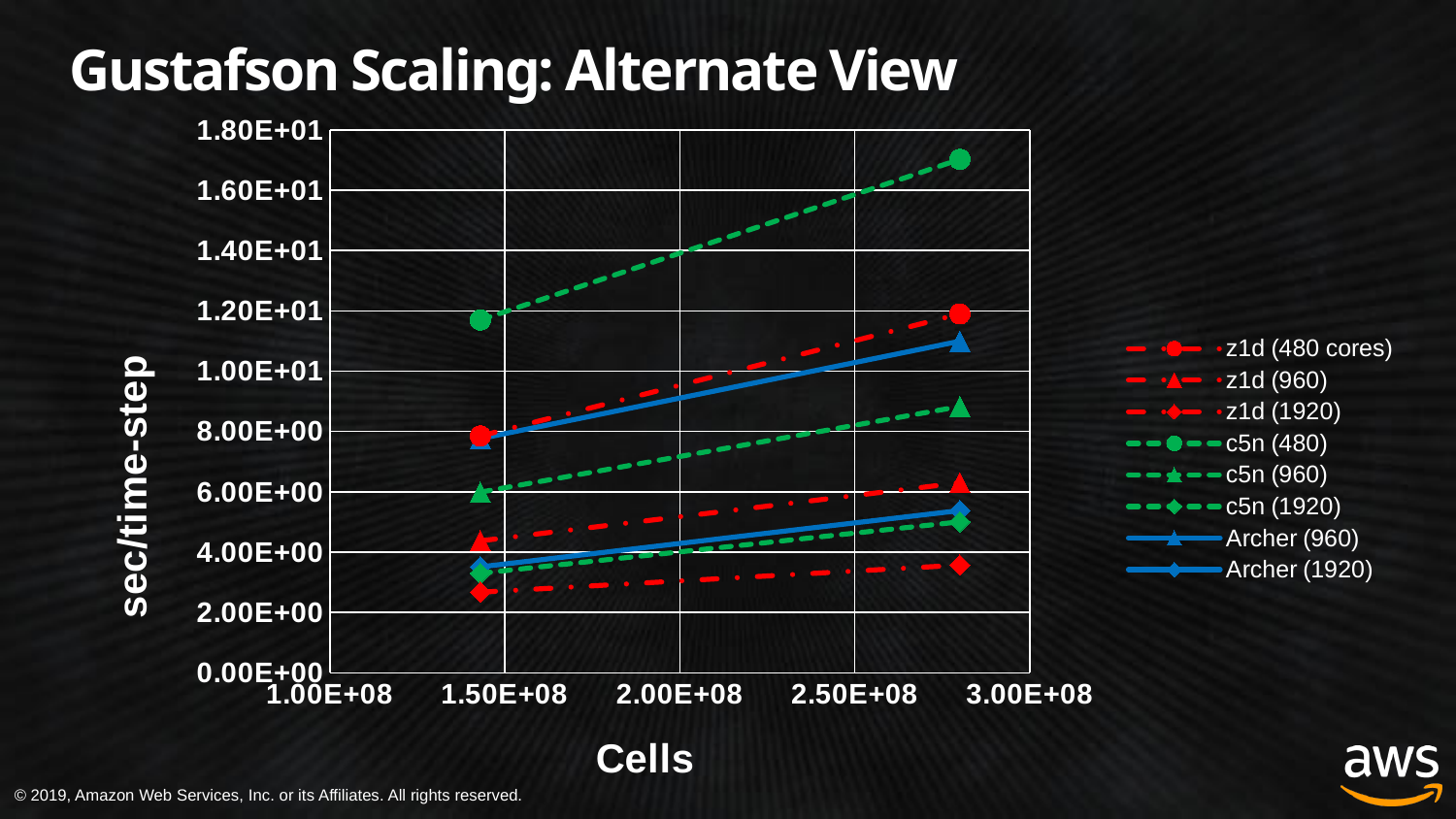
How many series does the legend list? 8 What is the label on the y axis? sec/time-step Which series has the lowest sec/time-step values across the chart? z1d (1920) Is the value for z1d (960) at the smaller cell count greater or less than 6.00E+00? less What kind of chart is shown on the slide? line chart Do the sec/time-step values rise or fall as the number of cells increases? rise Is the value for c5n (480) at the smaller cell count greater or less than 1.00E+01? greater At the larger cell count, which is higher: c5n (960) or z1d (960)? c5n (960) How many data points are plotted for each series? 2 Is the value for z1d (1920) at the larger cell count greater or less than 4.00E+00? less Which series has the highest sec/time-step value at the largest cell count? c5n (480)